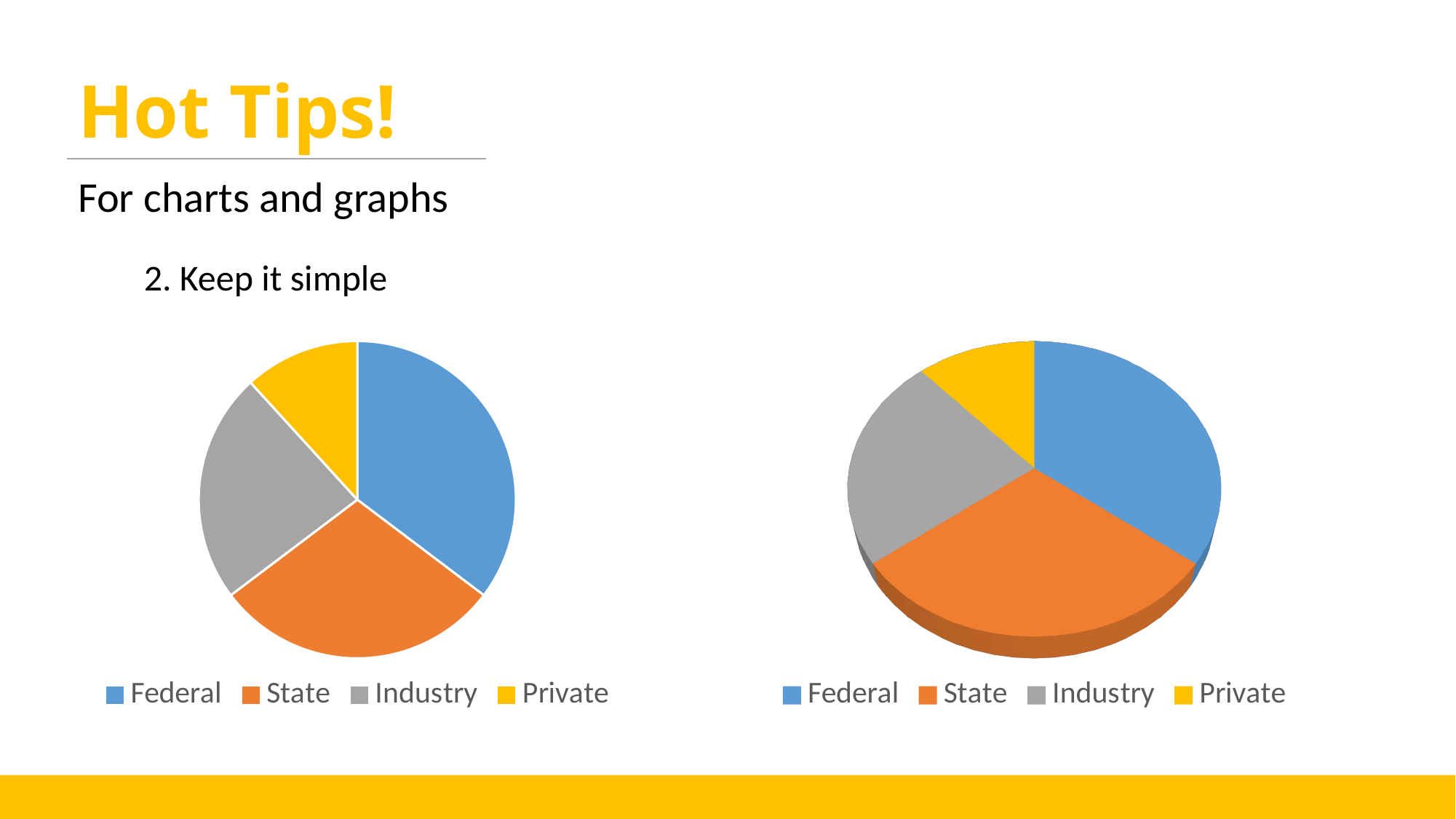
In the left pie chart, which slice is larger, Federal or Industry? Federal In the left pie chart, how many slices does the pie have? 4 What kind of chart is the chart on the left side of the slide? pie chart In the left pie chart, what colour is the Federal slice? blue Which of the two pie charts on the slide is drawn in 3D? the right one In the right pie chart, which category has the smallest slice? Private What kind of chart is the chart on the right side of the slide? pie chart In the right pie chart, which slice is larger, State or Industry? State In the left pie chart, which category has the smallest slice? Private In the right pie chart, which slice is larger, Federal or Private? Federal In the right pie chart, how many entries does the legend list? 4